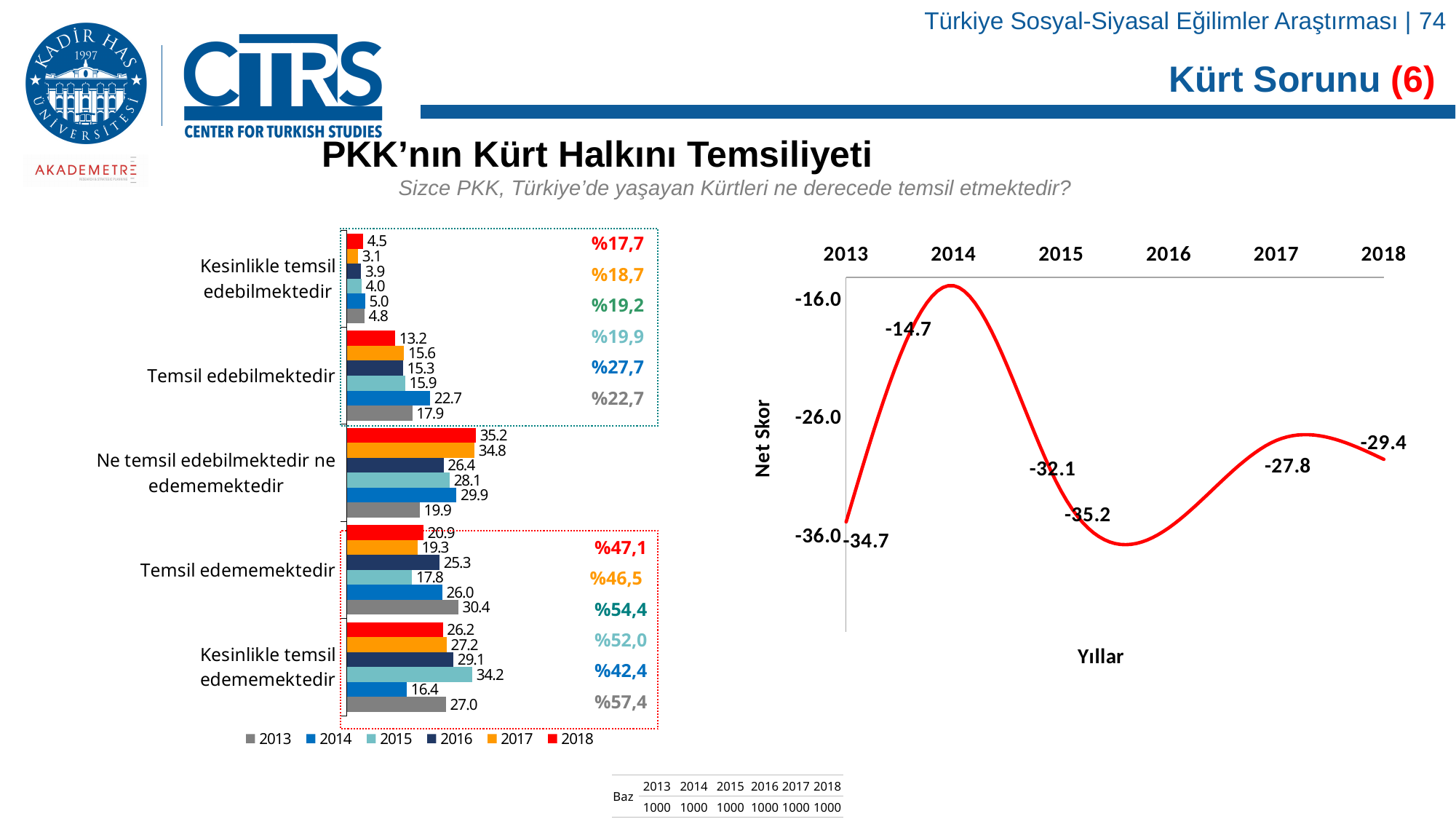
In the bar chart on the left, which is larger in the 'Kesinlikle temsil edememektedir' category: the 2014 value or the 2016 value? 2016 In the bar chart on the left, what is the value for 2018 in the 'Ne temsil edebilmektedir ne edememektedir' category? 35.2 In the bar chart on the left, what is the value for 2014 in the 'Temsil edebilmektedir' category? 22.7 In the line chart on the right (Net Skor), which year has the lowest value? 2016 In the line chart on the right (Net Skor), what is the value for 2014? -14.7 How many series does the legend of the bar chart on the left list? 6 In the bar chart on the left, which year has the highest value in the 'Kesinlikle temsil edememektedir' category? 2015 In the bar chart on the left, what is the difference between the 2013 and 2018 values in the 'Temsil edememektedir' category? 9.5 In the bar chart on the left, which year has the lowest value in the 'Kesinlikle temsil edebilmektedir' category? 2017 In the line chart on the right (Net Skor), is the value for 2013 greater or less than -26.0? less What kind of chart is shown on the right side of the slide? line chart How many categories are shown in the bar chart on the left? 5